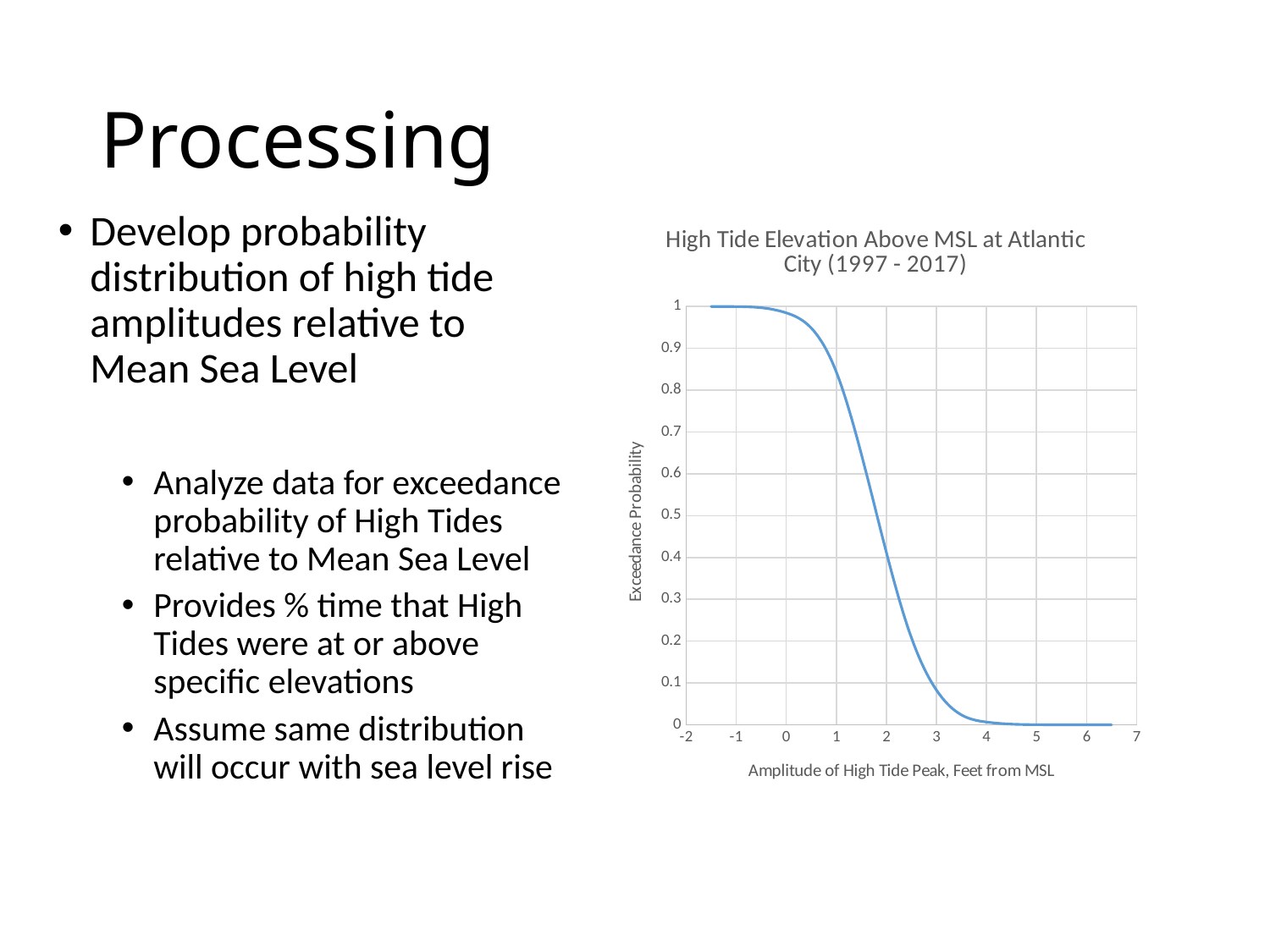
What kind of chart is shown on the slide? line chart Is the exceedance probability at an amplitude of -1 foot greater or less than 0.9? greater Is the exceedance probability at an amplitude of 2 feet greater or less than 0.5? less Is the exceedance probability at an amplitude of 2 feet greater or less than 0.3? greater What is the label of the x axis of the chart? Amplitude of High Tide Peak, Feet from MSL Does the exceedance probability rise or fall as the amplitude of high tide peak increases? fall What is the title of the chart? High Tide Elevation Above MSL at Atlantic City (1997 - 2017) Which has the higher exceedance probability, an amplitude of 1 foot or an amplitude of 3 feet? 1 foot